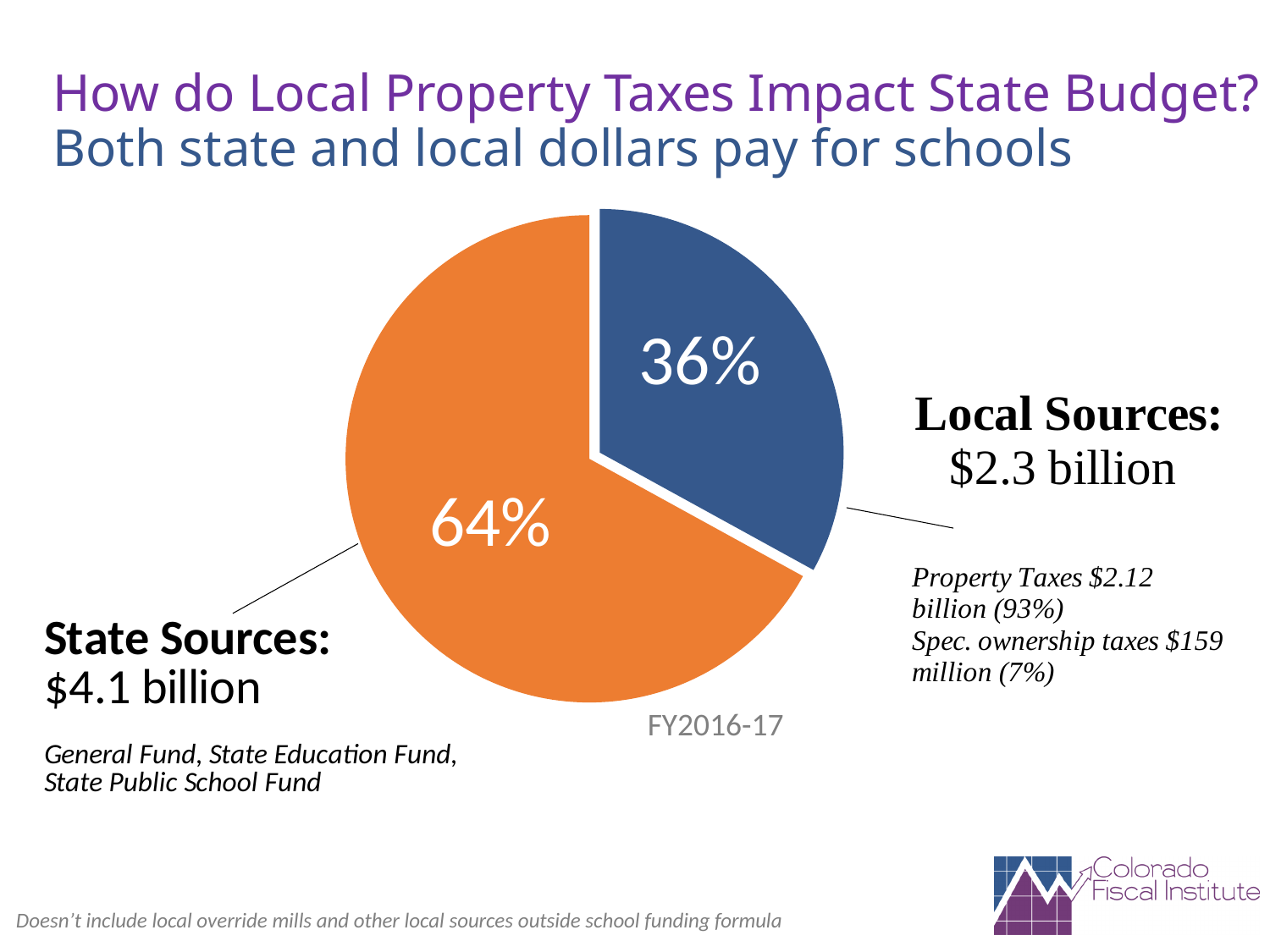
What fiscal year does the pie chart cover? FY2016-17 Which slice of the pie is the smallest? Local Sources Which is larger, the State Sources share or the Local Sources share? State Sources What share of the pie is Local Sources? 36% How many slices does the pie chart have? 2 What is the dollar value for Local Sources? $2.3 billion What is the difference in percentage points between the State Sources share and the Local Sources share? 28 percentage points What kind of chart is shown on the slide? pie chart What share of the pie is State Sources? 64% What colour is the Local Sources slice? blue Which slice of the pie is the largest? State Sources What is the dollar value for State Sources? $4.1 billion